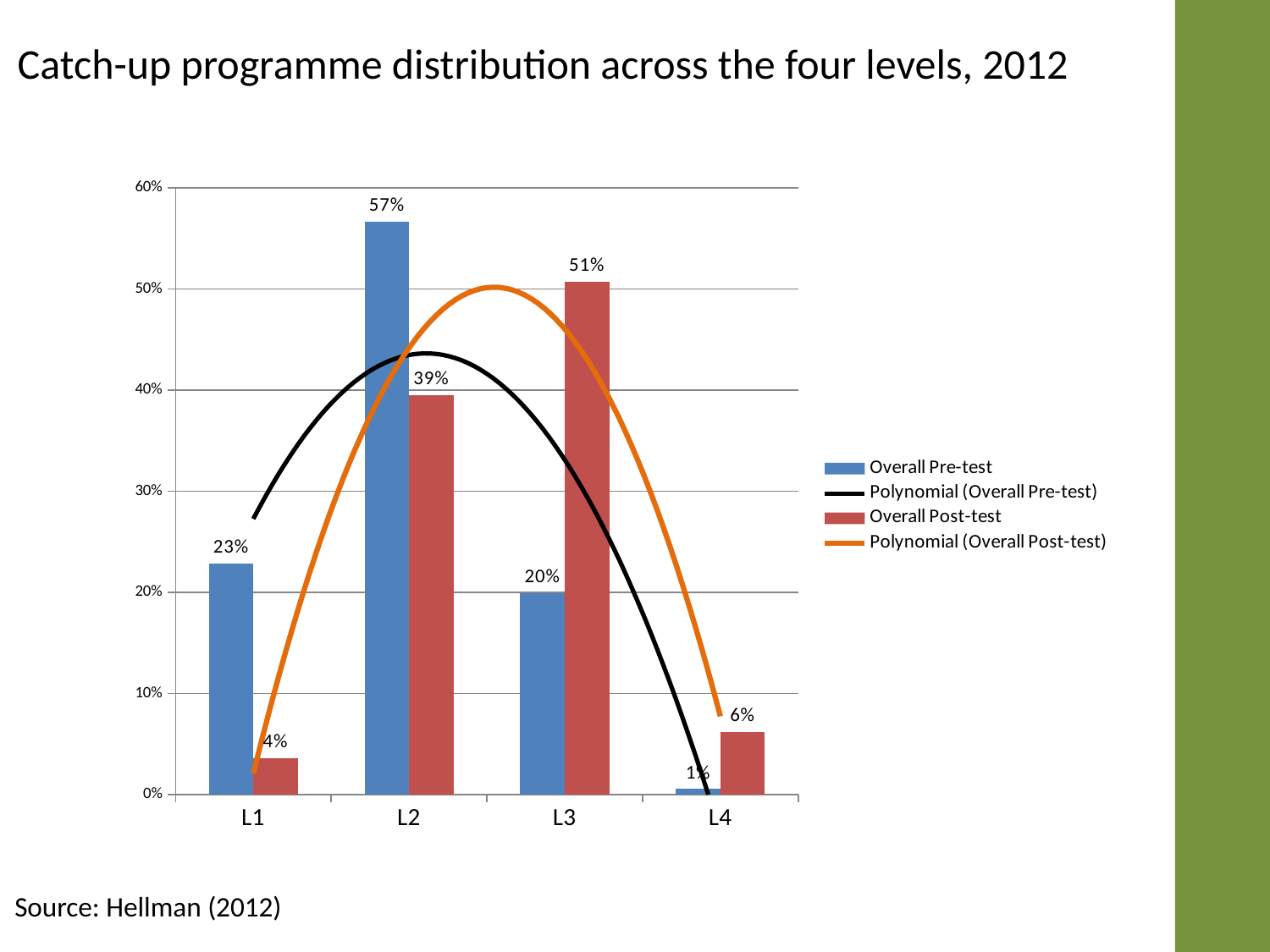
Which is larger for L3: the Overall Pre-test value or the Overall Post-test value? Overall Post-test What is the Overall Pre-test value for L4? 1% What is the Overall Post-test value for L3? 51% What is the Overall Pre-test value for L2? 57% Which level has the highest Overall Pre-test value? L2 How many levels are shown on the x axis? 4 How many entries does the legend list? 4 What is the Overall Post-test value for L1? 4% Is the Overall Post-test value for L2 greater or less than 30%? greater What type of chart is shown on the slide? Bar chart Which level has the lowest Overall Post-test value? L1 What is the difference between the Overall Pre-test and Overall Post-test values for L2? 18%